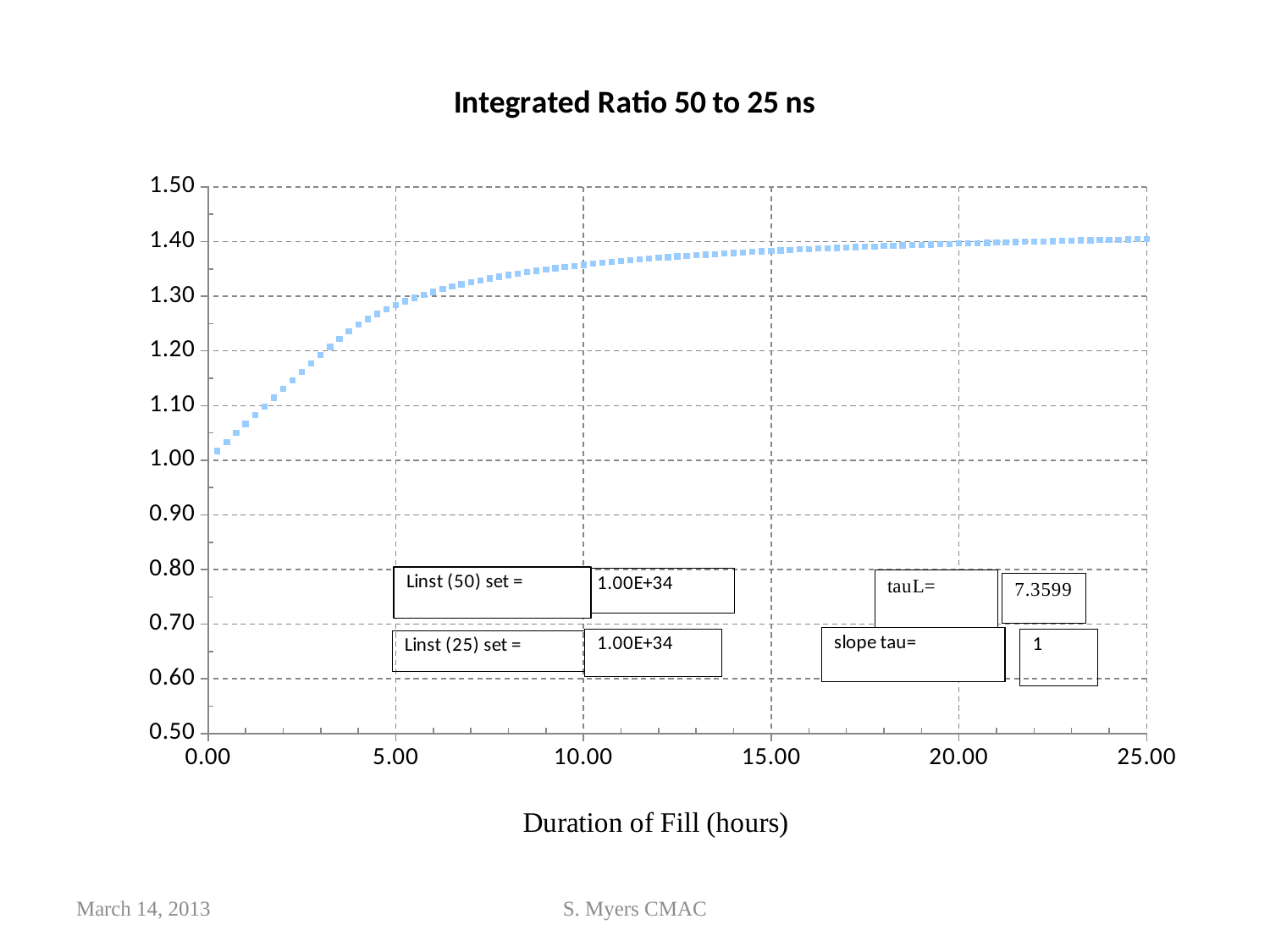
What value is given for tauL in the annotation box on the chart? 7.3599 Is the value at a Duration of Fill of 25.00 hours greater or less than 1.30? greater Does the Integrated Ratio rise or fall as the Duration of Fill increases? rise Is the value at a Duration of Fill of 2.00 hours greater or less than 1.20? less Which is larger, the value at 5.00 hours or the value at 20.00 hours? 20.00 hours What kind of chart is shown on the slide? scatter chart Is the value at a Duration of Fill of 5.00 hours greater or less than 1.20? greater What is the title of the chart? Integrated Ratio 50 to 25 ns